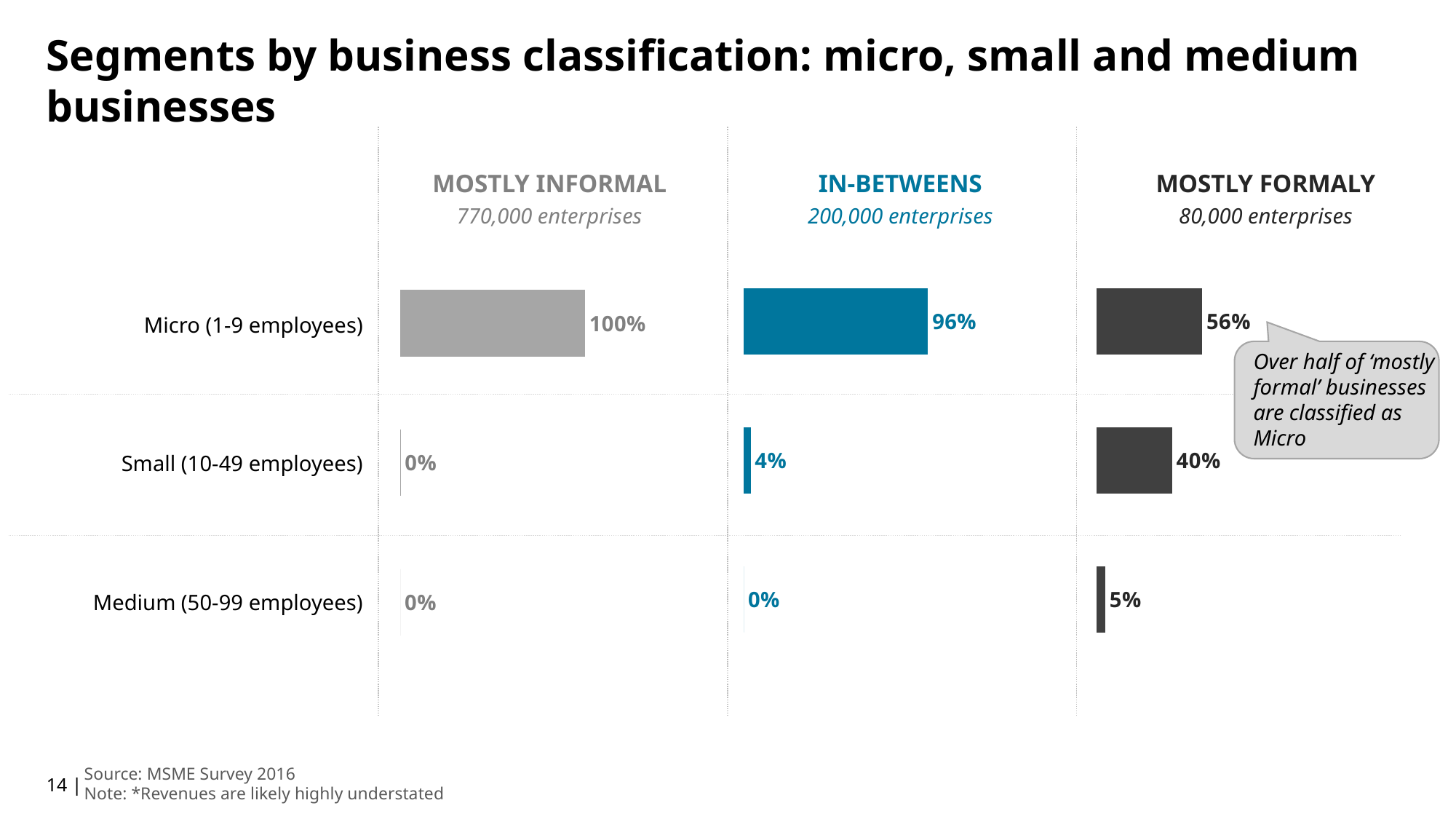
In the 'Mostly Formaly' chart, which category has the lowest value? Medium (50-99 employees) Which is larger: the Micro (1-9 employees) value in the 'In-Betweens' chart or in the 'Mostly Formaly' chart? In-Betweens In the 'Mostly Formaly' chart, what is the value for Micro (1-9 employees)? 56% How many categories are shown in the 'In-Betweens' chart? 3 In the 'In-Betweens' chart, what is the value for Small (10-49 employees)? 4% In the 'Mostly Formaly' chart, what is the difference between the values for Micro (1-9 employees) and Small (10-49 employees)? 16% In the 'Mostly Formaly' chart, what is the value for Medium (50-99 employees)? 5% What type of chart is used in the 'Mostly Informal' segment? Bar chart In the 'Mostly Formaly' chart, which category has the highest value? Micro (1-9 employees) What colour are the bars in the 'In-Betweens' chart? Blue In the 'Mostly Informal' chart, what is the value for Micro (1-9 employees)? 100% How many enterprises are in the 'In-Betweens' segment according to the chart header? 200,000 enterprises